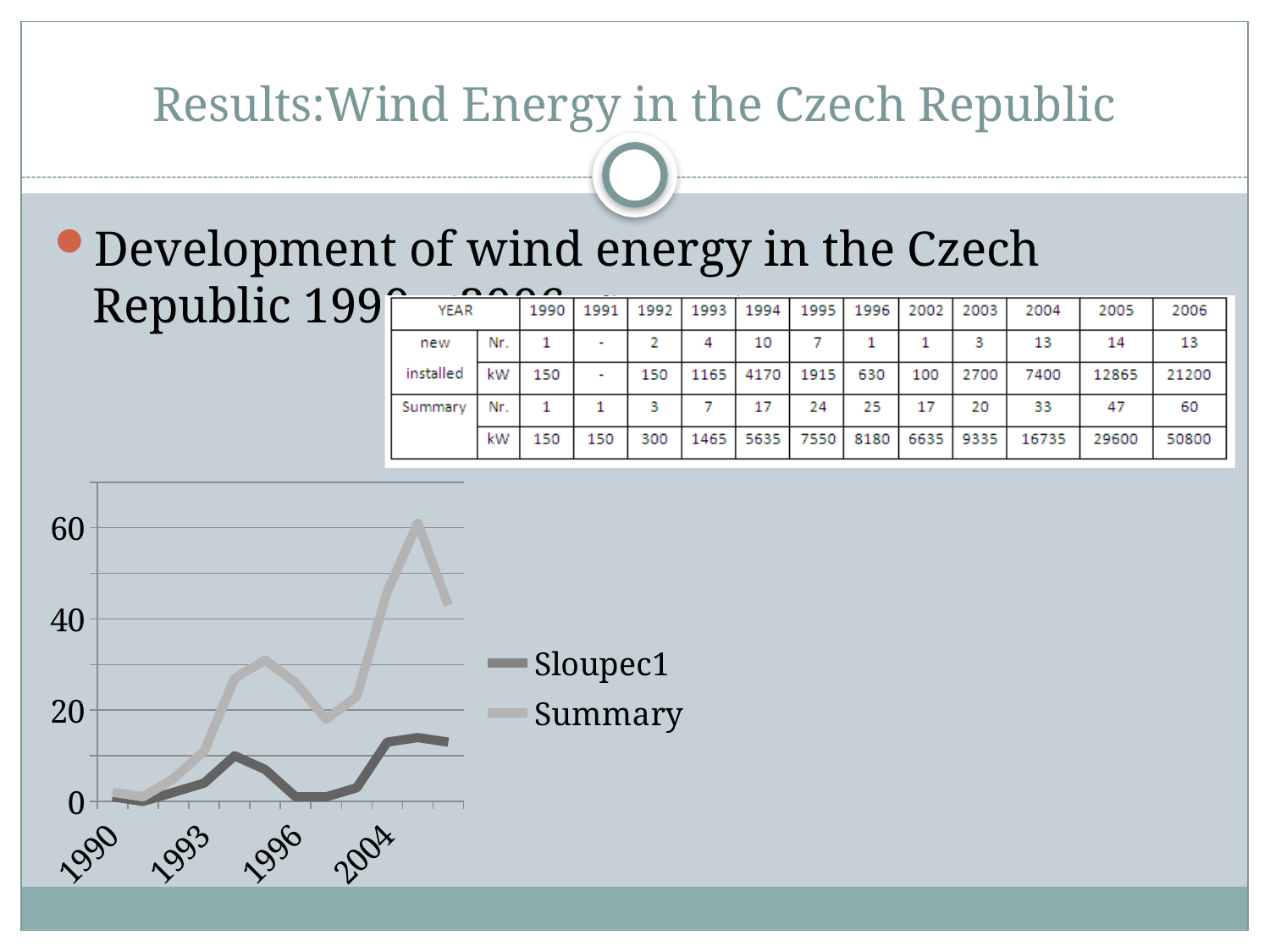
Is the value for Sloupec1 at 2004 greater or less than 20? less Does the Summary series generally rise or fall from 1990 to 2004? rise Which series is drawn with the lighter grey line? Summary What are the two series named in the chart legend? Sloupec1 and Summary What kind of chart is shown on the slide? line chart Is the value for Summary at 1993 greater or less than 20? less Is the peak value of the Summary series greater or less than 40? greater Which series reaches the highest value on the chart? Summary At 2004, which series has the larger value, Sloupec1 or Summary? Summary How many series does the chart legend list? 2 How many year labels are shown on the x axis of the chart? 4